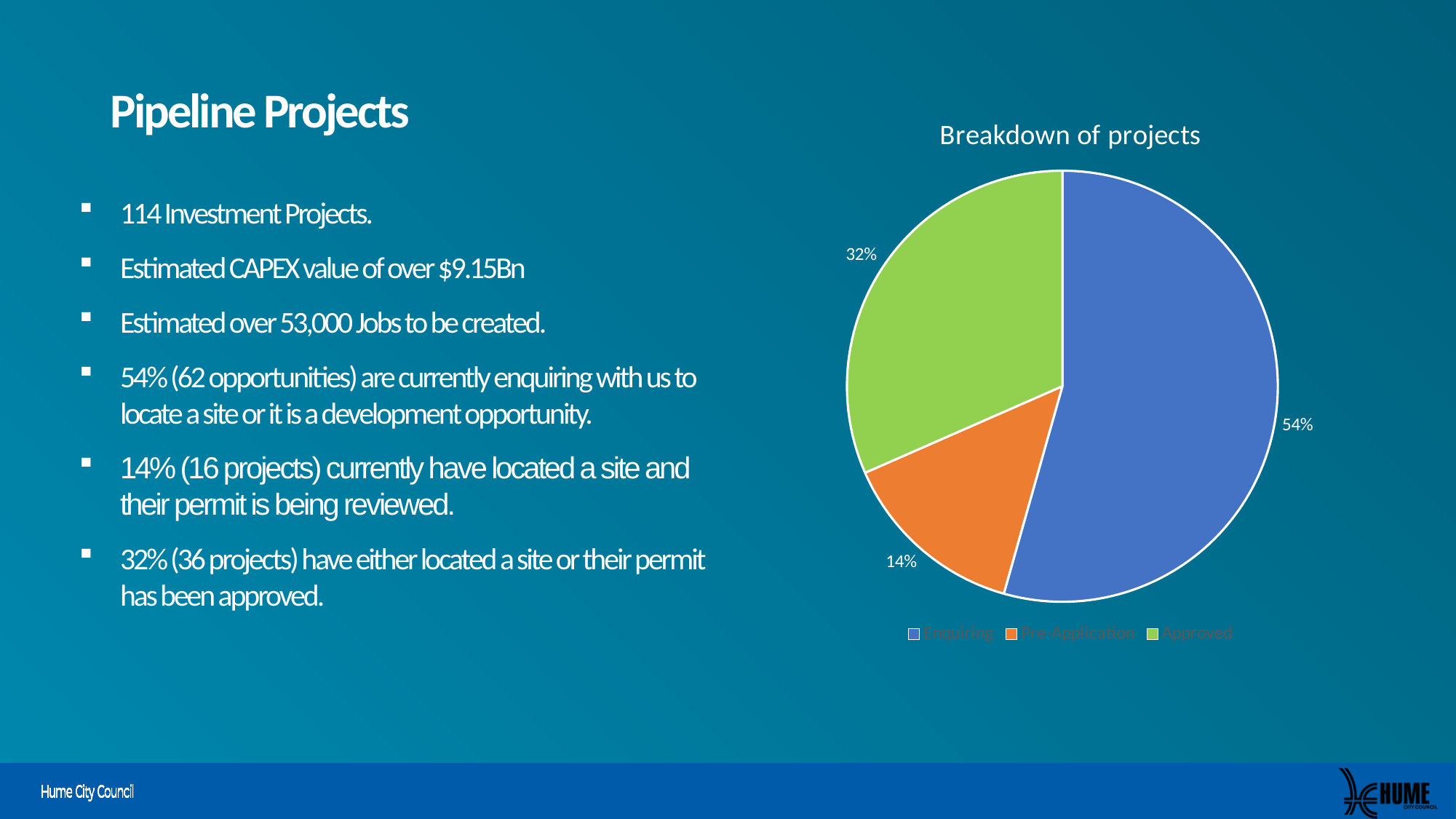
What is the difference in percentage points between the Enquiring and Approved slices? 22 How many slices does the pie chart have? 3 What type of chart is shown on the slide? pie chart What colour is the Approved slice? green What share of the pie does the Approved slice represent? 32% What share of the pie does the Enquiring slice represent? 54% Which category has the smallest slice of the pie? Pre-Application What share of the pie does the Pre-Application slice represent? 14% How many entries does the legend list? 3 Which category has the largest slice of the pie? Enquiring Which slice is larger, Approved or Pre-Application? Approved What is the title of the chart? Breakdown of projects